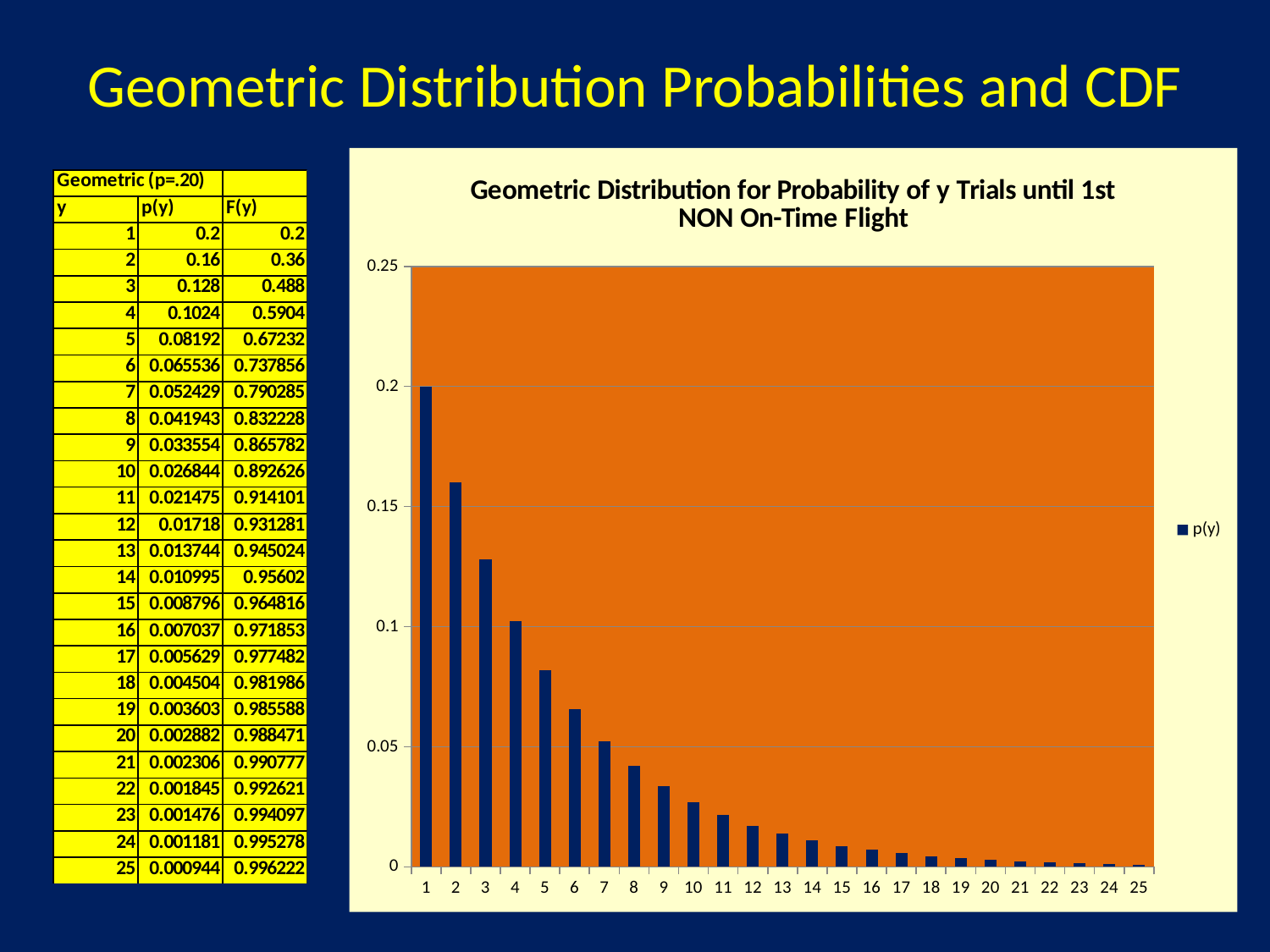
What kind of chart is shown on the slide? bar chart Is the bar for y = 2 greater or less than 0.15? greater Which bar is taller, y = 3 or y = 6? y = 3 What is the value of p(y) for y = 1 in the chart? 0.2 Is the bar for y = 7 greater or less than 0.05? greater Which value of y has the lowest bar in the chart? 25 Which value of y has the highest bar in the chart? 1 How many series does the chart legend list? 1 What is the name of the series shown in the chart legend? p(y) Is the bar for y = 5 greater or less than 0.1? less How many categories (values of y) are plotted along the x axis of the chart? 25 Do the bar heights rise or fall as y increases along the x axis? fall